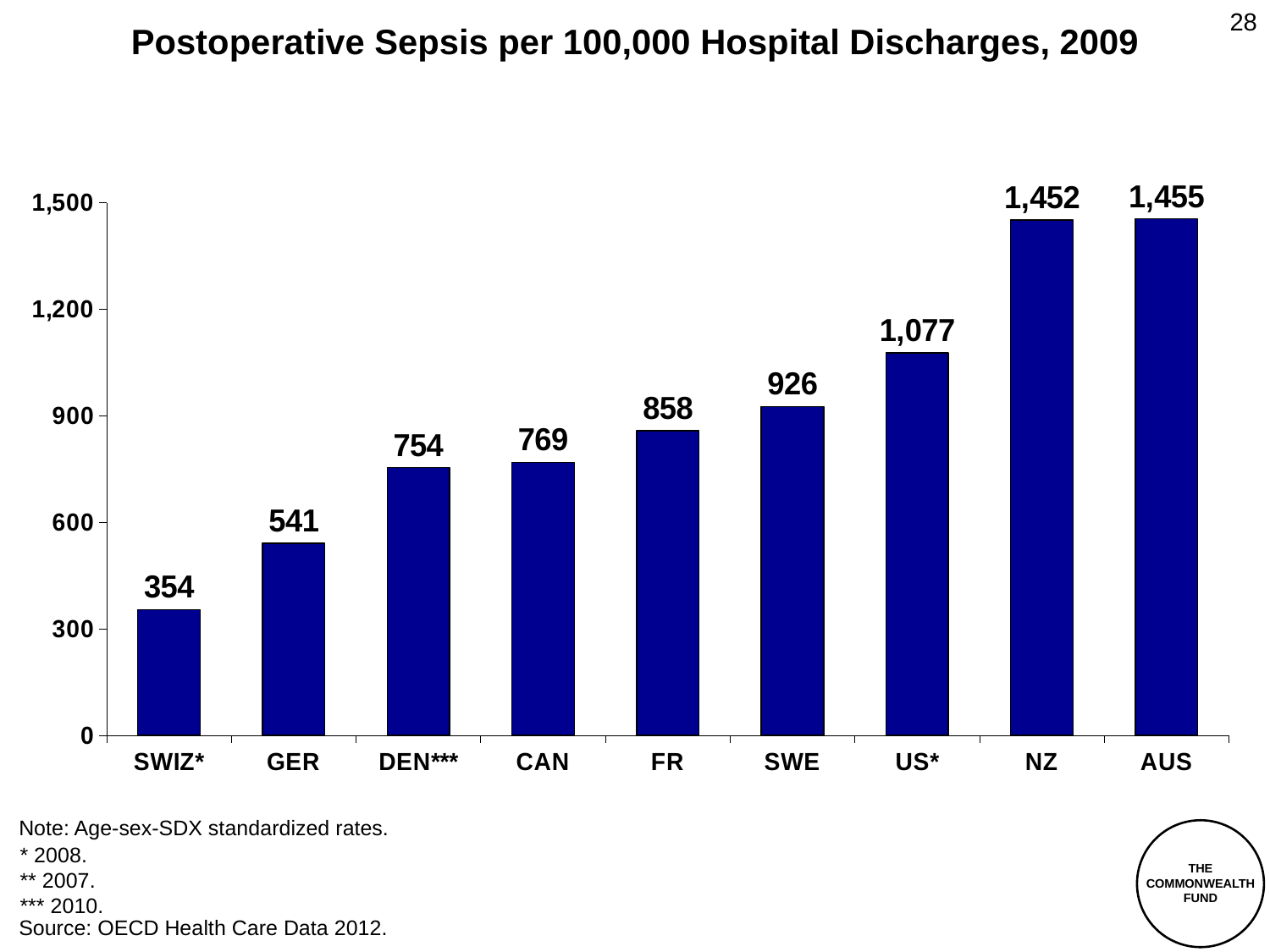
What is the postoperative sepsis rate per 100,000 hospital discharges for the US*? 1,077 What is the difference between the values for NZ and US*? 375 What is the value for DEN***? 754 Do the values rise or fall from left to right across the x axis? Rise Is the value for SWE greater or less than 900? greater How many countries are shown in the chart? 9 What is the value for SWE? 926 Which country has the lowest postoperative sepsis rate? SWIZ* What type of chart is shown on the slide? Bar chart What is the difference between the values for CAN and GER? 228 What value is shown for GER? 541 Which has a higher value, FR or CAN? FR